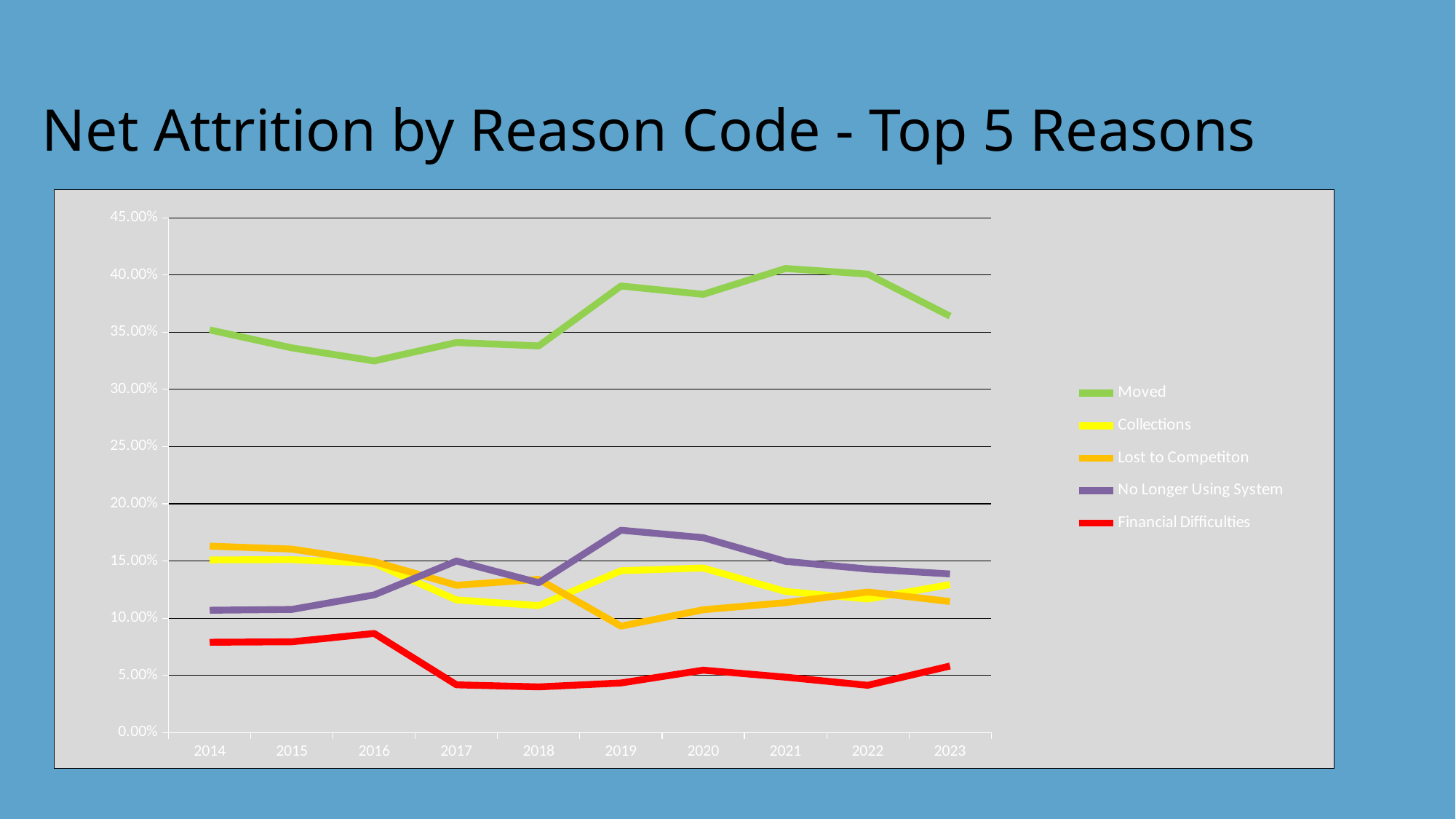
Is the value for No Longer Using System in 2019 greater or less than 15.00%? greater In 2014, which is larger: Lost to Competiton or No Longer Using System? Lost to Competiton How many series does the legend list? 5 Which reason code has the lowest attrition values across all years? Financial Difficulties How many years are shown on the x axis? 10 Is the value for Financial Difficulties in 2017 greater or less than 5.00%? less Which reason code has the highest attrition values across all years? Moved What kind of chart is shown on the slide? line chart Is the value for Moved in 2021 greater or less than 35.00%? greater In which year does Financial Difficulties reach its highest value? 2016 Does the Moved line rise or fall from 2014 to 2016? fall What colour is the line for Moved in the legend? green